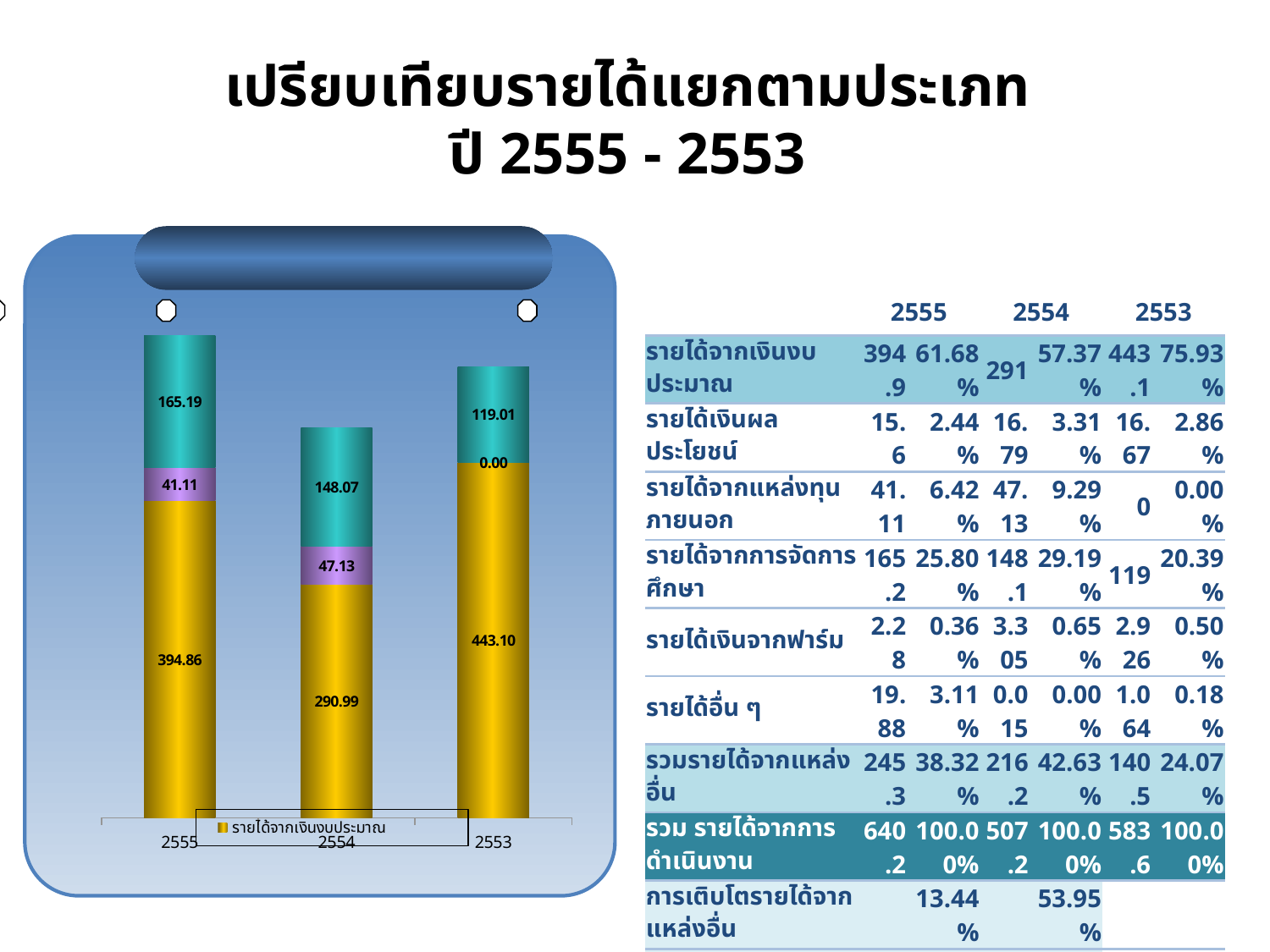
What is the total of the stacked bar for 2554? 486.19 Which year has the smallest yellow segment (รายได้จากเงินงบประมาณ)? 2554 What is the difference between the yellow segment values for 2553 and 2555? 48.24 Which year has the larger teal top segment, 2555 or 2553? 2555 What is the total of the stacked bar for 2555? 601.16 What kind of chart is shown on the slide? Stacked bar chart What is the value of the yellow segment (รายได้จากเงินงบประมาณ) for 2555? 394.86 What series name is shown in the chart legend? รายได้จากเงินงบประมาณ What is the value of the teal top segment for 2554? 148.07 What is the value of the purple segment for 2553? 0.00 Which year has the largest yellow segment (รายได้จากเงินงบประมาณ)? 2553 How many years (categories) are plotted on the x axis of the chart? 3